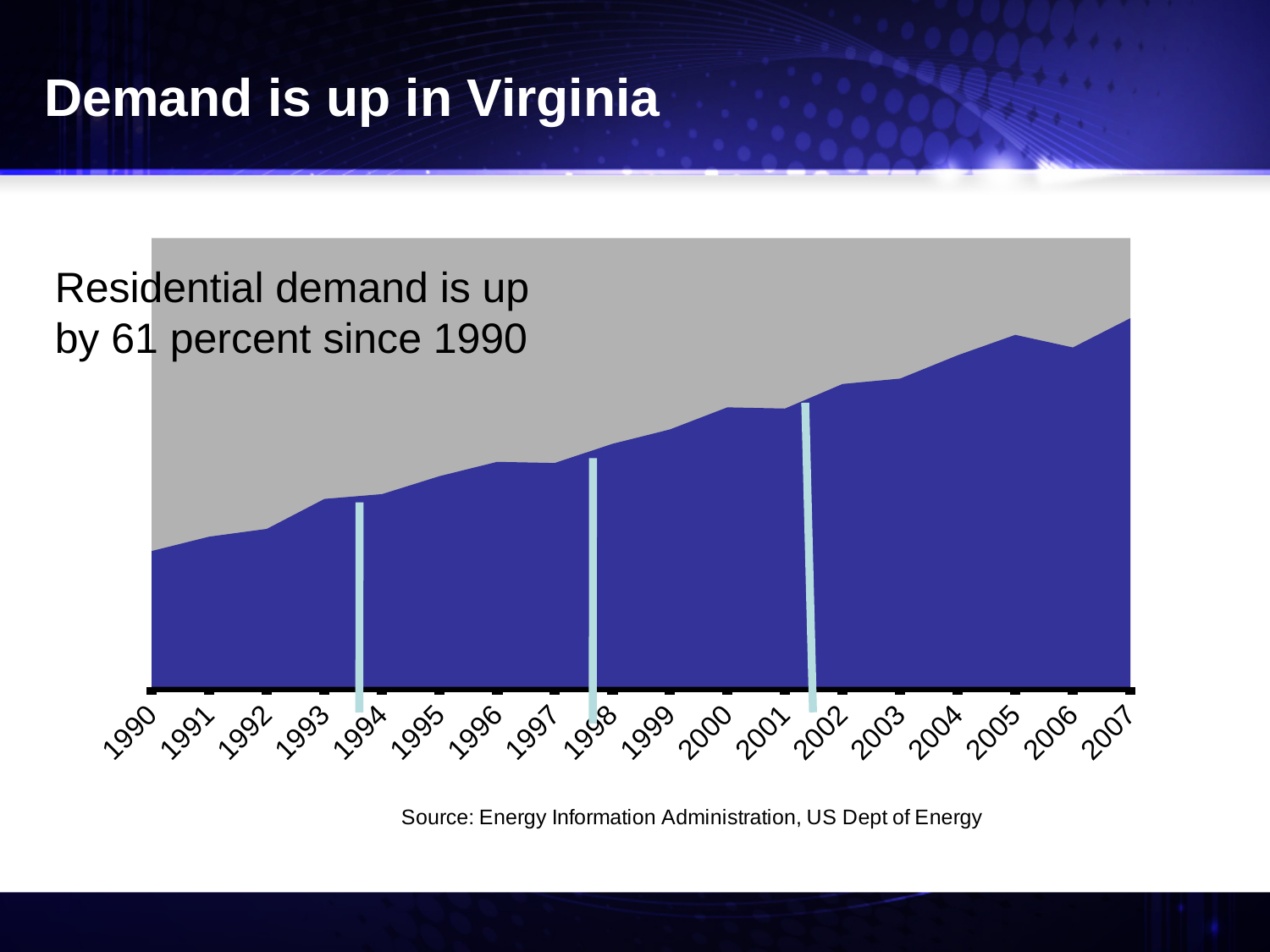
Which year has the larger value in the chart, 2005 or 2006? 2005 What is the last year shown on the x axis of the chart? 2007 Which year has the larger value in the chart, 1990 or 2007? 2007 Which year has the larger value in the chart, 2006 or 2007? 2007 What kind of chart is shown on the slide? Area chart How many years are shown along the x axis of the chart? 18 Which year has the highest value in the chart? 2007 Which year has the lowest value in the chart? 1990 What is the first year shown on the x axis of the chart? 1990 Do the values in the chart generally rise or fall from 1990 to 2007? Rise